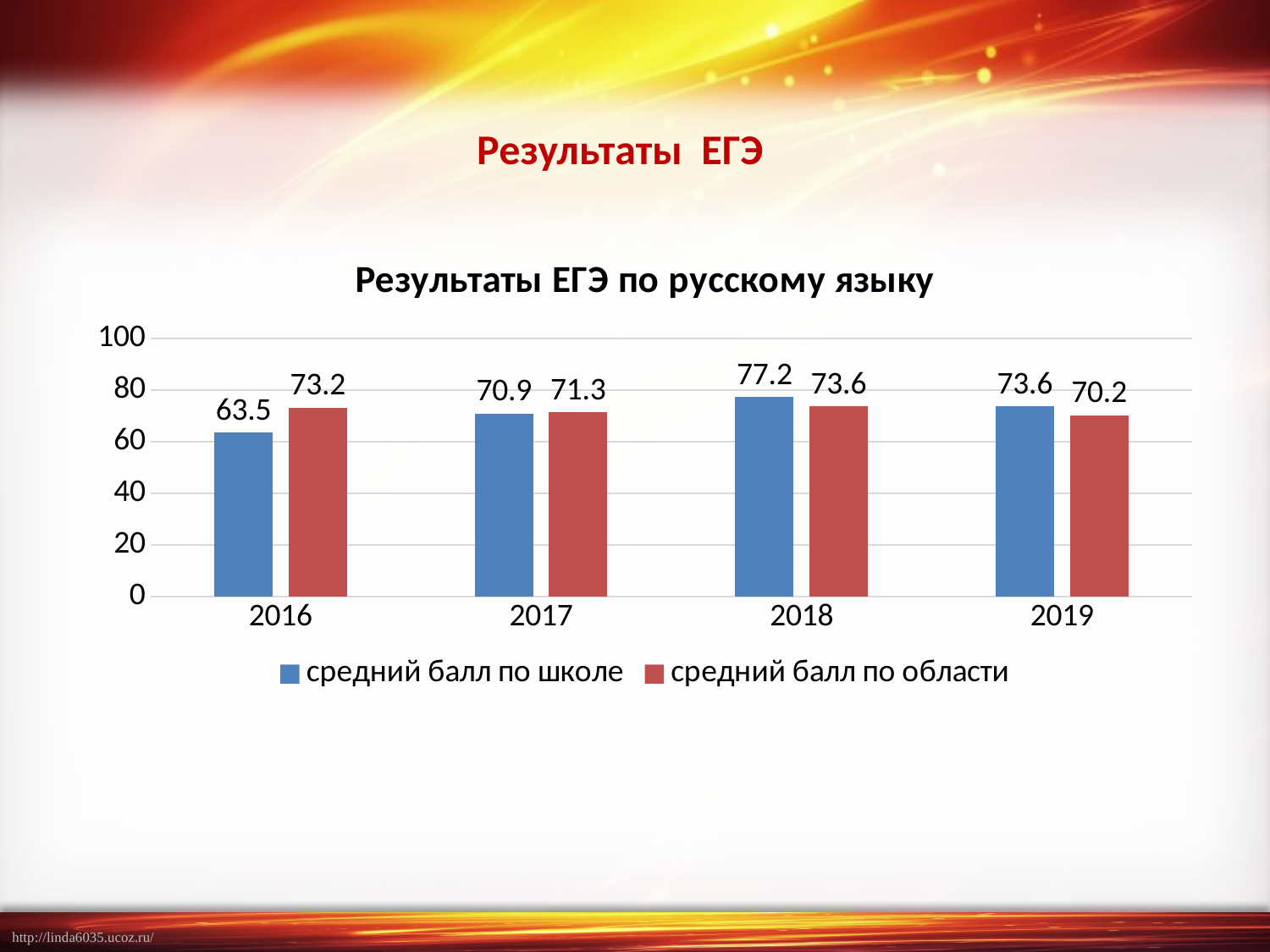
Which is larger in 2019: 'средний балл по школе' or 'средний балл по области'? средний балл по школе What is the title of the chart? Результаты ЕГЭ по русскому языку Is the value for 'средний балл по школе' in 2017 greater or less than 60? greater What is the value for 'средний балл по школе' in 2016? 63.5 In which year is 'средний балл по школе' lowest? 2016 In which year is 'средний балл по школе' highest? 2018 How many years are shown on the x axis? 4 What is the value for 'средний балл по школе' in 2018? 77.2 What is the value for 'средний балл по области' in 2019? 70.2 How many series does the legend list? 2 What is the difference between 'средний балл по области' and 'средний балл по школе' in 2016? 9.7 What kind of chart is shown? bar chart